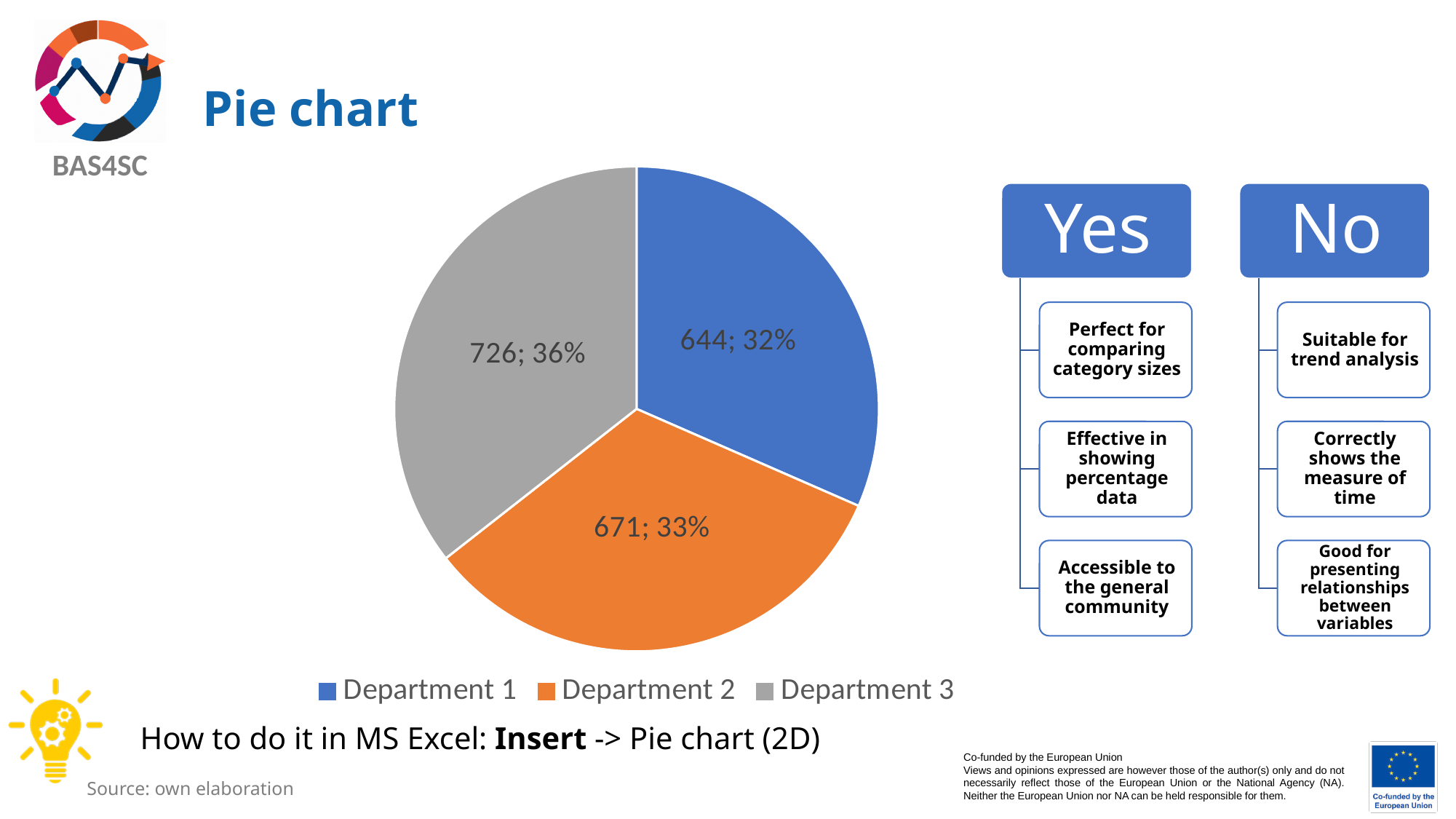
What is the difference between the values for Department 3 and Department 1? 82 What share of the pie does Department 3 represent? 36% Which department has the smallest slice? Department 1 What share of the pie does Department 1 represent? 32% What is the value for Department 1? 644 What is the value for Department 3? 726 What is the value for Department 2? 671 What colour is the slice for Department 2? Orange Which department has the largest slice? Department 3 Which is larger, the value for Department 2 or Department 1? Department 2 What kind of chart is shown on the slide? Pie chart How many slices does the pie chart have? 3